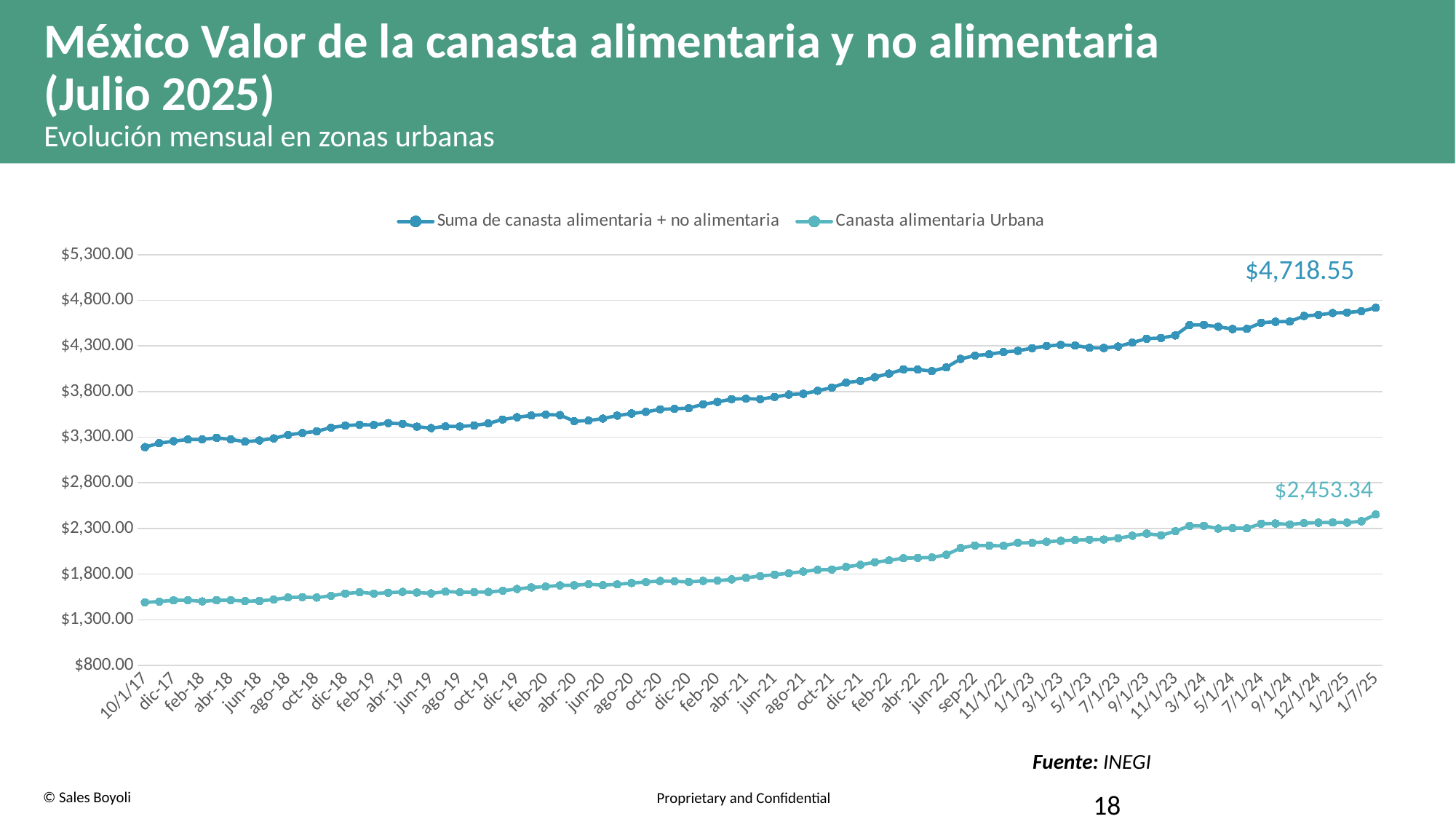
Is the value of 'Canasta alimentaria Urbana' at 10/1/17 greater or less than $1,800.00? less At which date does the 'Suma de canasta alimentaria + no alimentaria' series reach its highest value? 1/7/25 Which series has the higher value at 1/7/25? Suma de canasta alimentaria + no alimentaria Is the value of 'Suma de canasta alimentaria + no alimentaria' at abr-20 greater or less than $3,300.00? greater What is the value of the 'Suma de canasta alimentaria + no alimentaria' series at 1/7/25? $4,718.55 How many series does the legend list? 2 Is the value of 'Suma de canasta alimentaria + no alimentaria' at 10/1/17 greater or less than $3,300.00? less What is the value of the 'Canasta alimentaria Urbana' series at 1/7/25? $2,453.34 At which date is the 'Canasta alimentaria Urbana' series at its lowest value? 10/1/17 What kind of chart is shown on the slide? Line chart Do the values of the 'Canasta alimentaria Urbana' series generally rise or fall from 10/1/17 to 1/7/25? Rise What is the difference between the two series' values at 1/7/25? $2,265.21